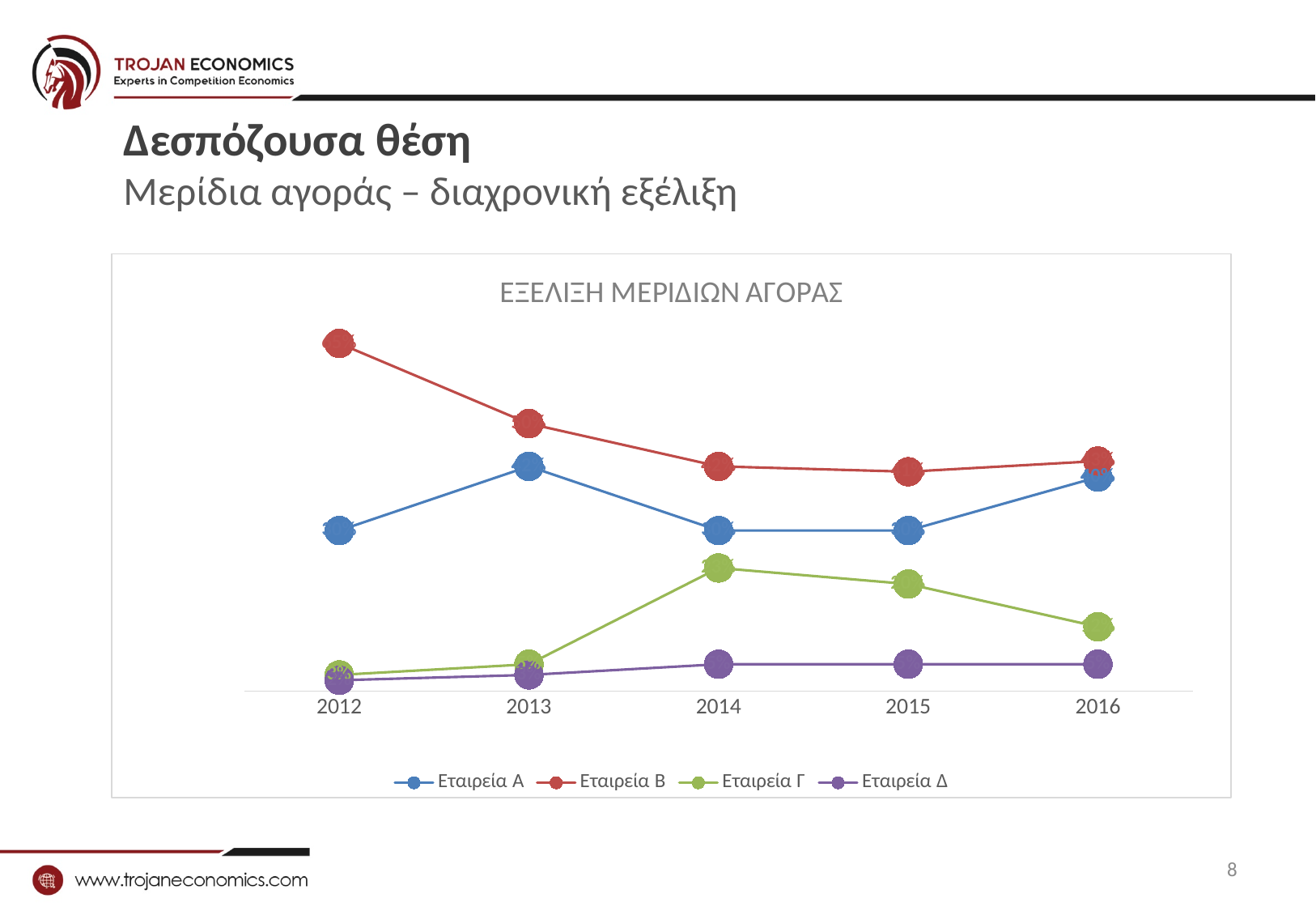
Does the market share of Εταιρεία Γ rise or fall from 2014 to 2016? fall Does the market share of Εταιρεία Β rise or fall from 2012 to 2014? fall Which company has the lowest market share in 2012? Εταιρεία Δ How many series does the legend list? 4 Which company has the highest market share in 2012? Εταιρεία Β Which company has the lowest market share in 2016? Εταιρεία Δ What is the title of the chart? ΕΞΕΛΙΞΗ ΜΕΡΙΔΙΩΝ ΑΓΟΡΑΣ How many years are shown on the x axis? 5 In 2013, which is larger: the market share of Εταιρεία Β or Εταιρεία Α? Εταιρεία Β Which company has the highest market share in 2016? Εταιρεία Β In 2014, which is larger: the market share of Εταιρεία Α or Εταιρεία Γ? Εταιρεία Α What kind of chart is shown on the slide? line chart